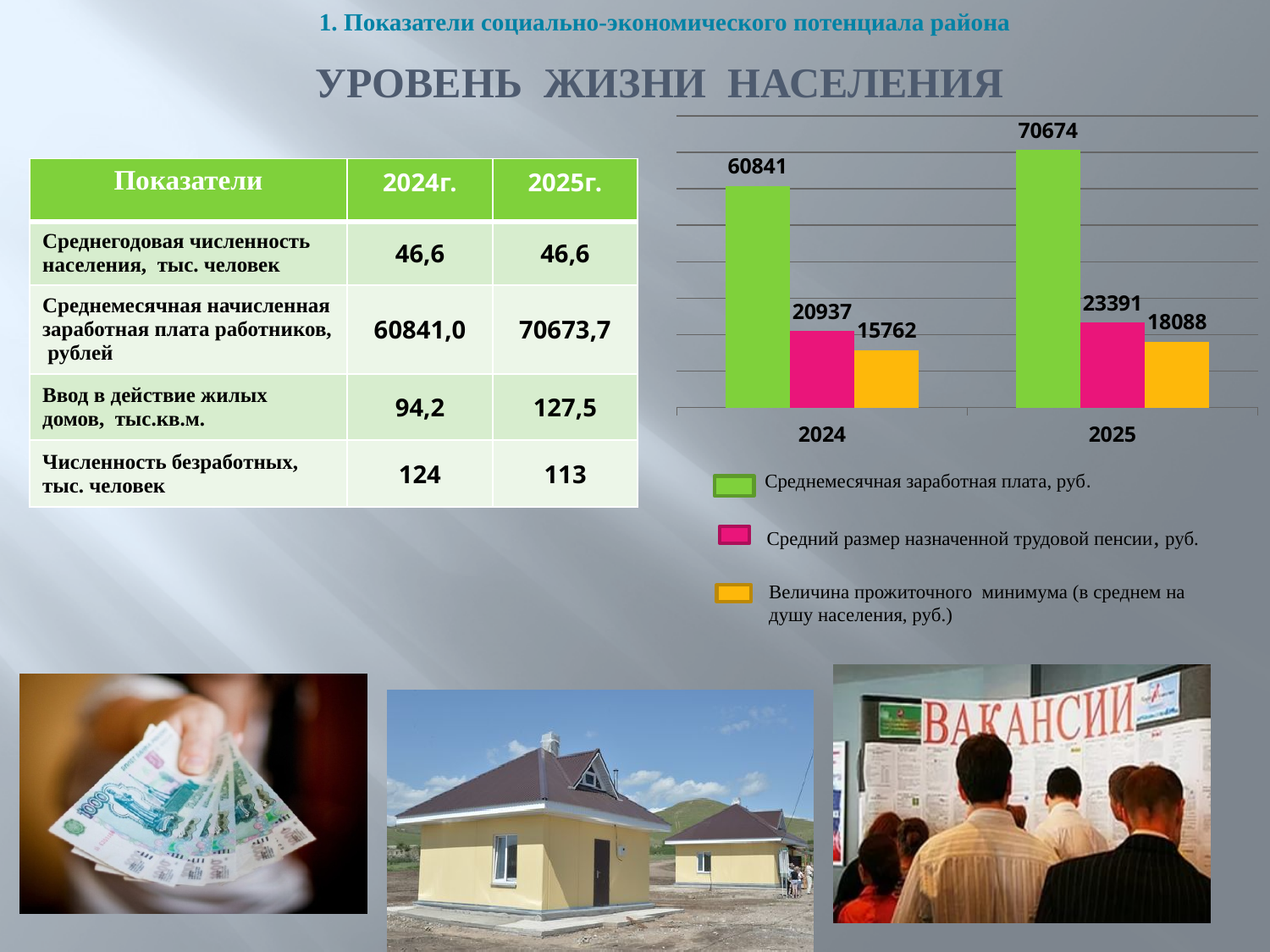
By how much did the average monthly wage in the chart increase from 2024 to 2025? 9833 What is the average monthly wage (Среднемесячная заработная плата) shown in the chart for 2024? 60841 What is the difference between the average pension and the subsistence minimum in the chart for 2025? 5303 How many year categories are shown on the x axis of the chart? 2 How many series does the chart's legend list? 3 Which year has the higher subsistence minimum in the chart, 2024 or 2025? 2025 What is the average assigned labour pension (Средний размер назначенной трудовой пенсии) shown in the chart for 2024? 20937 What is the subsistence minimum (Величина прожиточного минимума) shown in the chart for 2025? 18088 What type of chart is shown on the slide? bar chart What is the average monthly wage (Среднемесячная заработная плата) shown in the chart for 2025? 70674 Does the average pension in the chart rise or fall from 2024 to 2025? rise Which series has the lowest value in the chart for 2024? Величина прожиточного минимума (в среднем на душу населения, руб.)